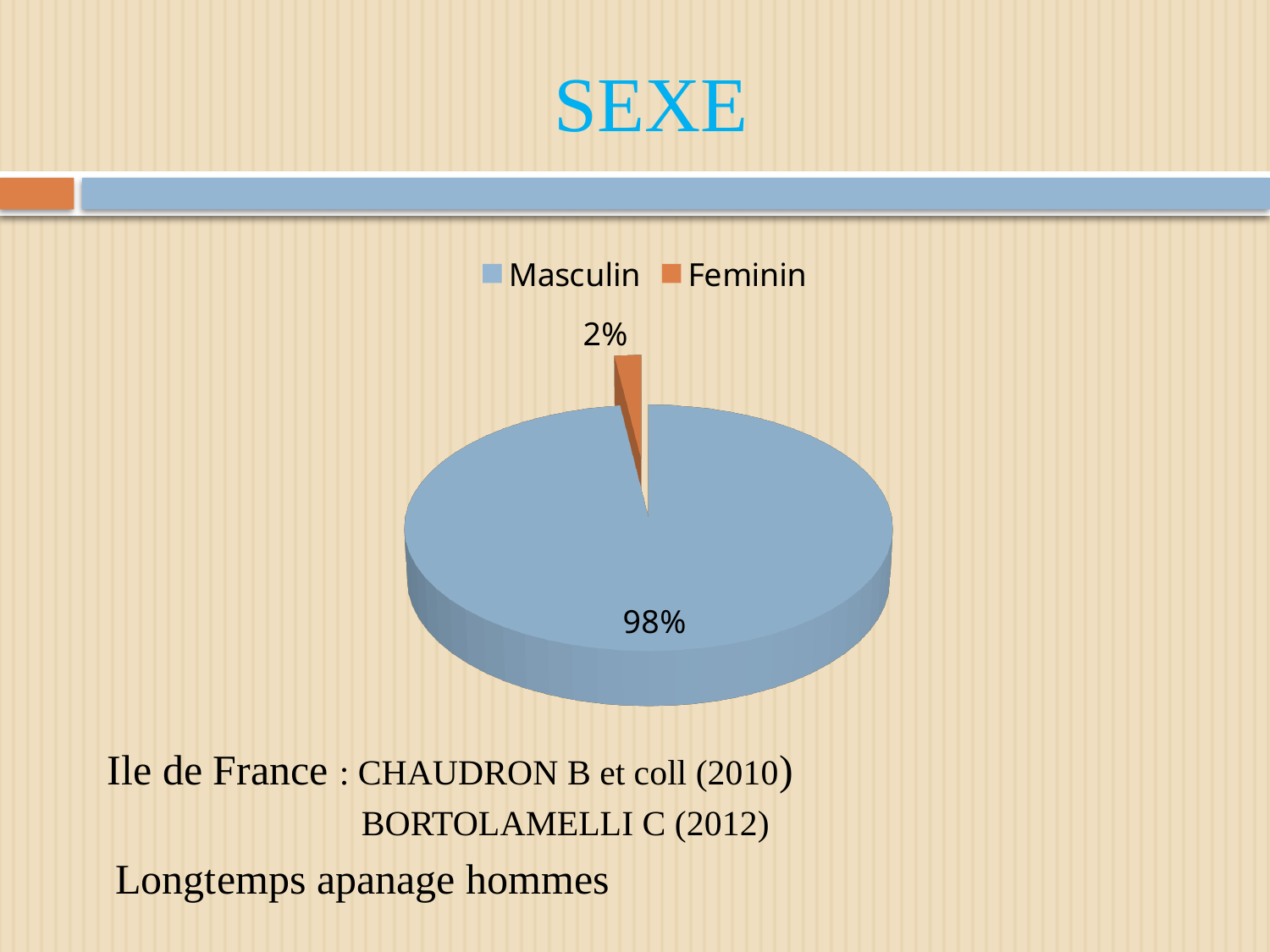
How many entries does the legend list? 2 Which category has the largest slice of the pie? Masculin How many categories does the pie chart show? 2 What kind of chart is shown on the slide? pie chart What colour is the Feminin slice in the pie chart? orange What is the title of the slide containing the chart? SEXE Which category has the smallest slice of the pie? Feminin What share of the pie does Feminin represent? 2% Which is larger, the Masculin slice or the Feminin slice? Masculin What share of the pie does Masculin represent? 98% What is the difference in percentage points between the Masculin and Feminin slices? 96